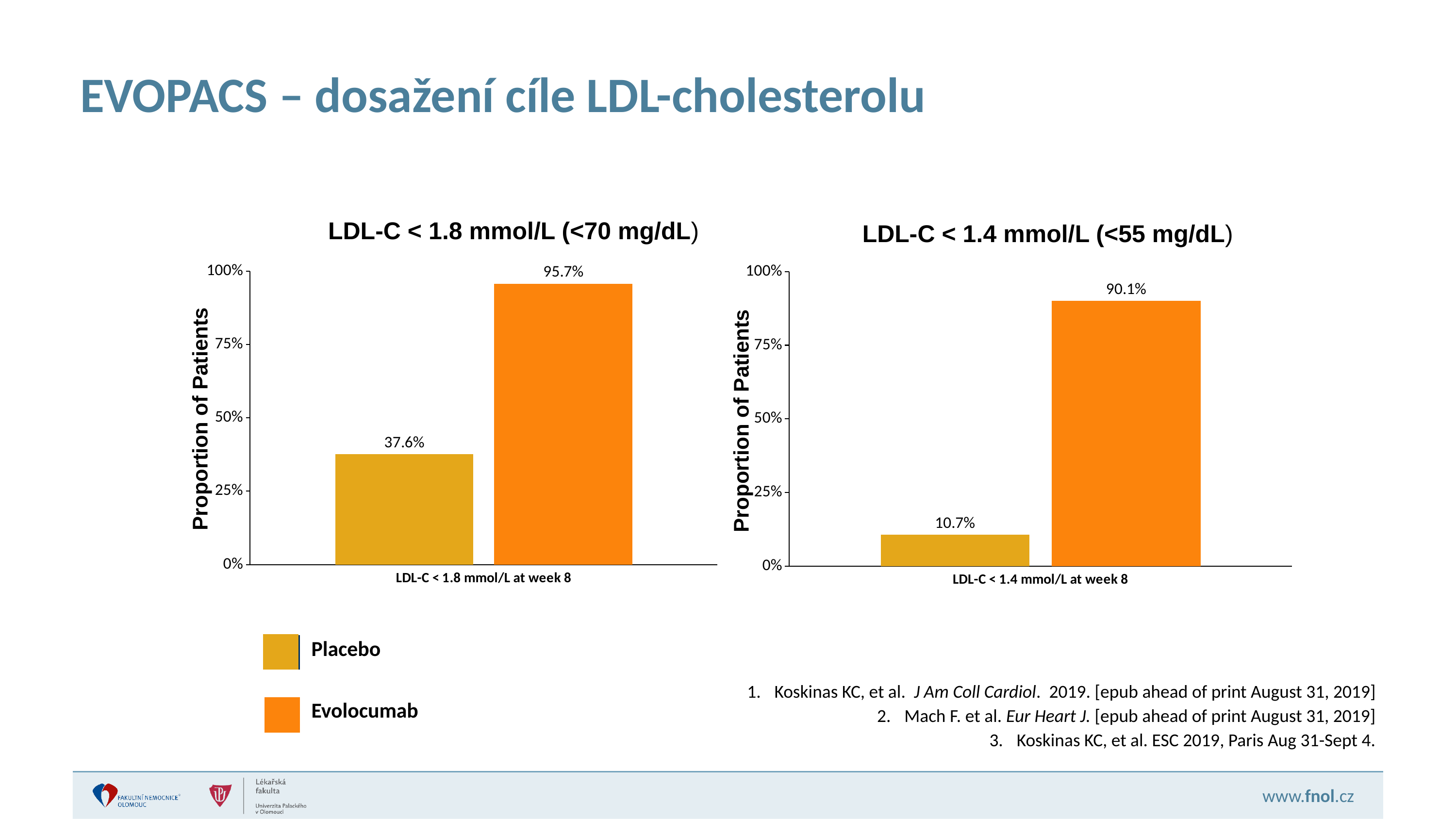
What kind of chart is the chart titled 'LDL-C < 1.8 mmol/L (<70 mg/dL)'? bar chart How many series does the legend on the slide list? 2 Is the Evolocumab value in the left chart (LDL-C < 1.8 mmol/L) larger or smaller than the Evolocumab value in the right chart (LDL-C < 1.4 mmol/L)? larger In the chart titled 'LDL-C < 1.4 mmol/L (<55 mg/dL)', which series has the lower value? Placebo In the chart titled 'LDL-C < 1.4 mmol/L (<55 mg/dL)', what is the value for Placebo? 10.7% In the chart titled 'LDL-C < 1.8 mmol/L (<70 mg/dL)', which series has the higher value? Evolocumab In the chart titled 'LDL-C < 1.8 mmol/L (<70 mg/dL)', what is the value for Evolocumab? 95.7% In the chart titled 'LDL-C < 1.8 mmol/L (<70 mg/dL)', what is the value for Placebo? 37.6% In the chart titled 'LDL-C < 1.8 mmol/L (<70 mg/dL)', what is the difference between the Evolocumab and Placebo values? 58.1% In the chart titled 'LDL-C < 1.4 mmol/L (<55 mg/dL)', what is the difference between the Evolocumab and Placebo values? 79.4% In the chart titled 'LDL-C < 1.4 mmol/L (<55 mg/dL)', what is the value for Evolocumab? 90.1% In the chart titled 'LDL-C < 1.4 mmol/L (<55 mg/dL)', is the value for Placebo greater or less than 25%? less